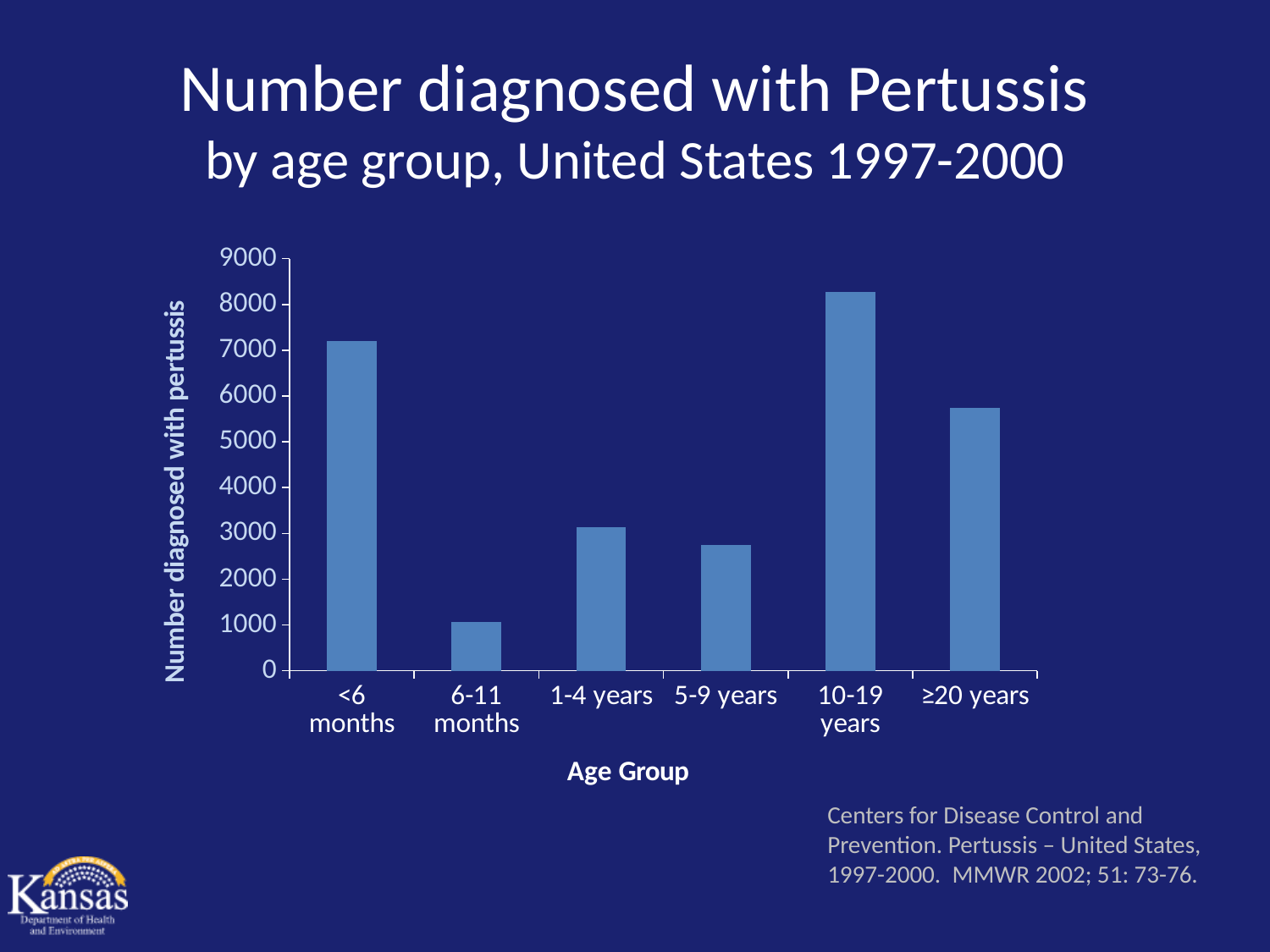
Is the value for <6 months greater or less than 6000? greater Is the value for 6-11 months greater or less than 2000? less Which age group has a higher number diagnosed with pertussis, <6 months or ≥20 years? <6 months Which age group has the highest number diagnosed with pertussis? 10-19 years Is the value for 5-9 years greater or less than 3000? less How many age groups are shown on the x axis of the chart? 6 Which age group has a higher number diagnosed with pertussis, 1-4 years or 5-9 years? 1-4 years Which age group has the lowest number diagnosed with pertussis? 6-11 months What kind of chart is shown on the slide? bar chart What is the title of the vertical axis of the chart? Number diagnosed with pertussis